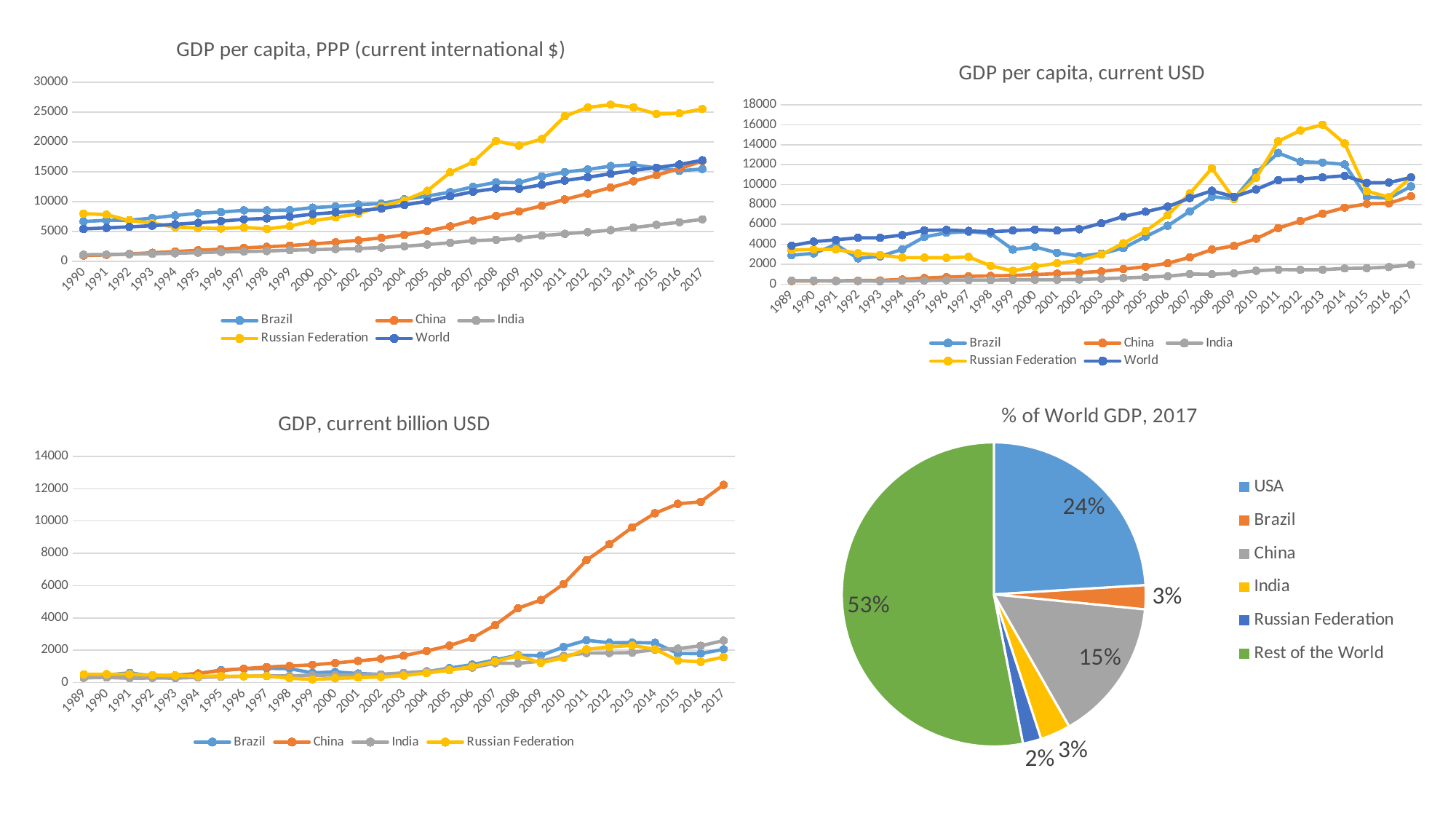
In the 'GDP per capita, current USD' chart, which is larger in 2011: Brazil or China? Brazil In the 'GDP per capita, PPP (current international $)' chart, is the value for Russian Federation in 2013 greater or less than 25000? greater In the '% of World GDP, 2017' pie chart, what share does Rest of the World have? 53% In the '% of World GDP, 2017' pie chart, which slice is the smallest? Russian Federation In the 'GDP per capita, current USD' chart, does China's value generally rise or fall from 1989 to 2017? rise What kind of chart is 'GDP, current billion USD'? line chart In the 'GDP, current billion USD' chart, which series has the highest value in 2017? China How many slices does the '% of World GDP, 2017' pie chart have? 6 In the '% of World GDP, 2017' pie chart, what share does the USA have? 24% How many series does the legend of the 'GDP per capita, PPP (current international $)' chart list? 5 How many series does the legend of the 'GDP, current billion USD' chart list? 4 In the '% of World GDP, 2017' pie chart, how many percentage points larger is the USA share than China's share? 9%